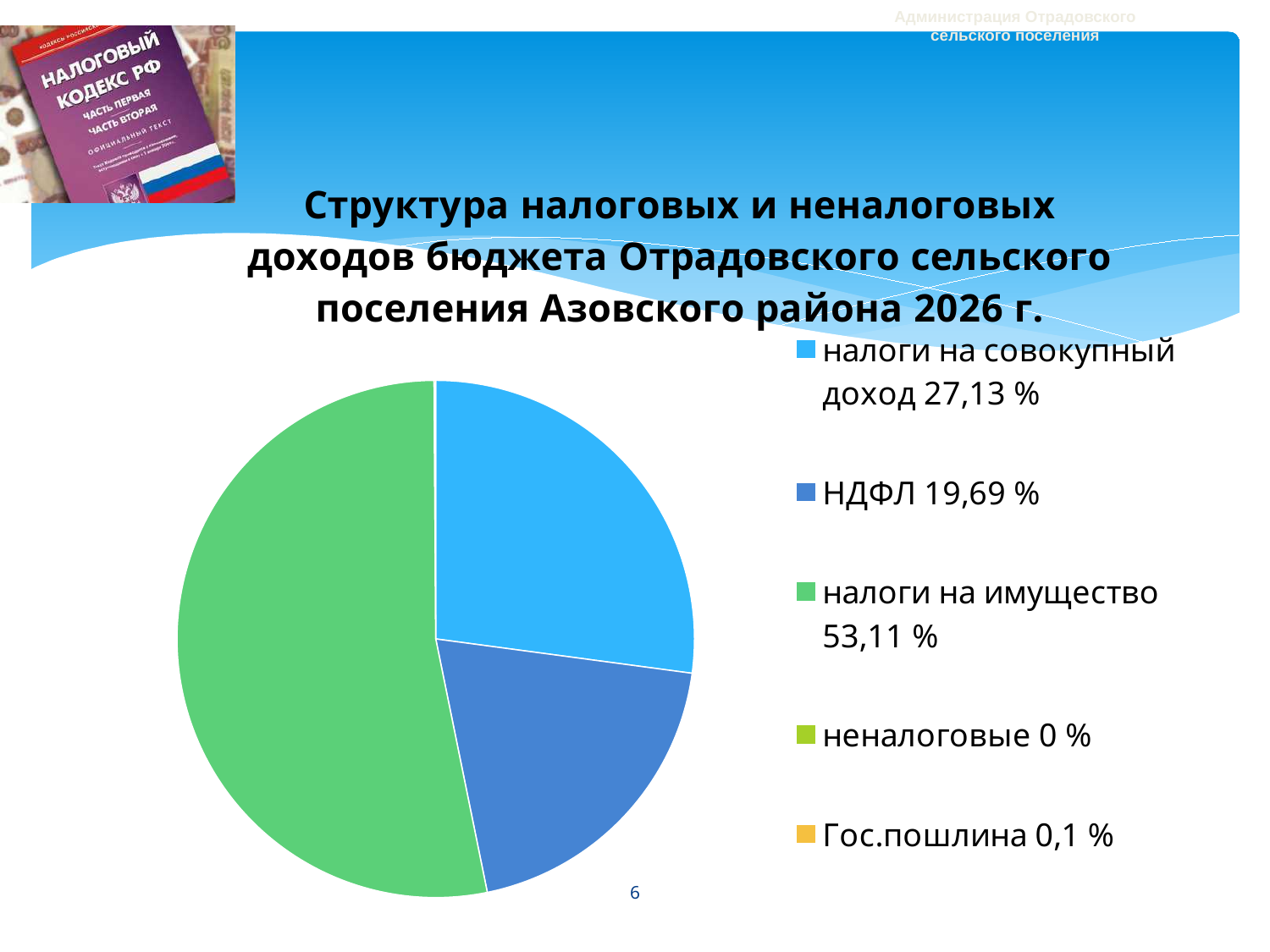
What share of the pie does "налоги на имущество" have? 53,11 % What value is shown for "неналоговые" in the legend? 0 % What colour is the slice for "налоги на имущество"? green What share of the pie does "налоги на совокупный доход" have? 27,13 % Which is larger: the share of "налоги на совокупный доход" or the share of "НДФЛ"? налоги на совокупный доход What value is shown for "Гос.пошлина" in the legend? 0,1 % Which category has the largest share of the pie? налоги на имущество What kind of chart is shown on the slide? pie chart How many categories does the legend list? 5 Which category has the smallest share according to the legend? неналоговые What share of the pie does "НДФЛ" have? 19,69 % What is the difference between the shares of "налоги на имущество" and "налоги на совокупный доход"? 25,98 %